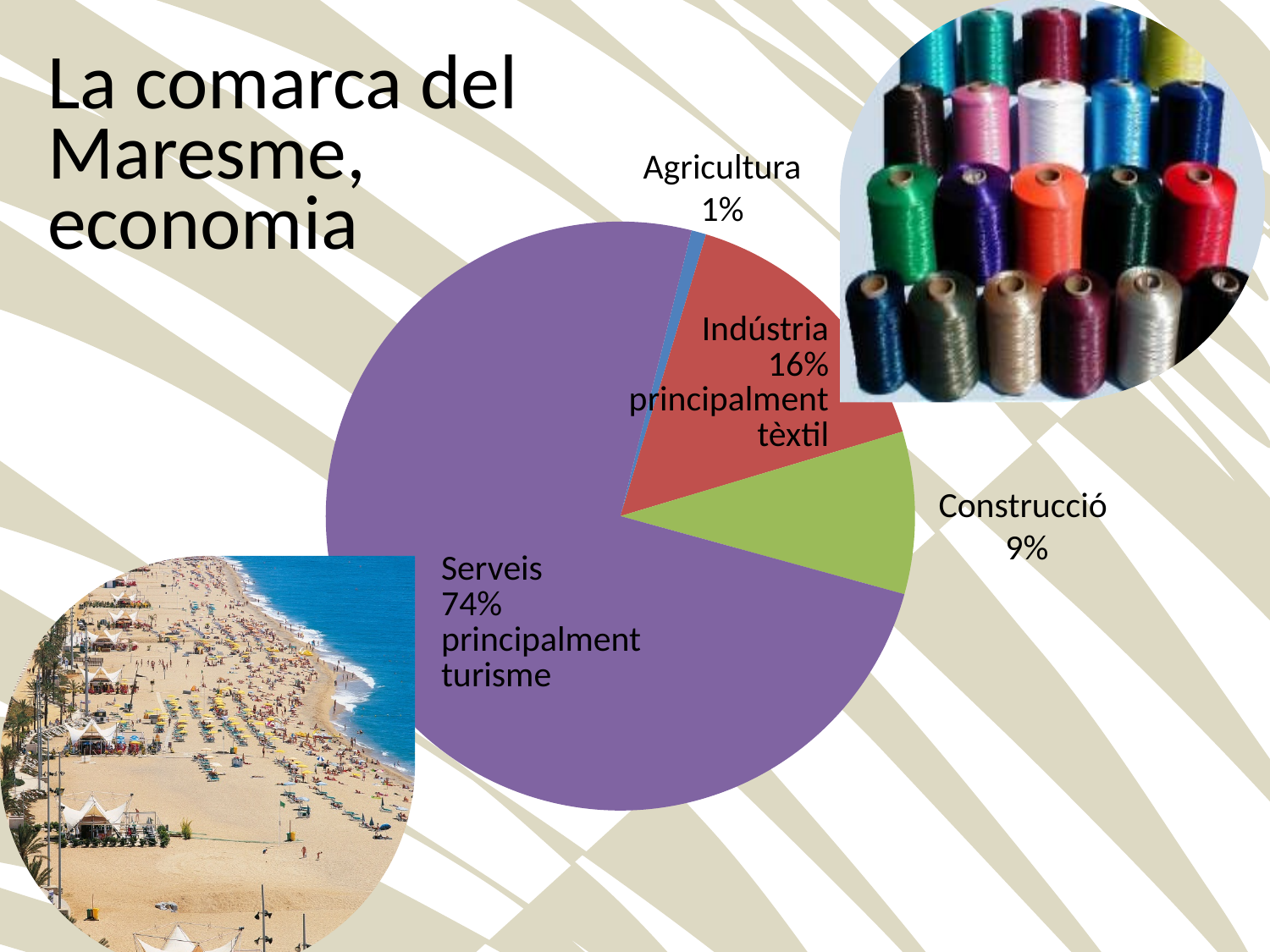
What kind of chart is shown on the slide? pie chart Which sector has the largest slice of the pie? Serveis What share of the pie does Agricultura represent? 1% What share of the pie does Construcció represent? 9% What is the difference in percentage points between Serveis and Indústria? 58 How many slices does the pie chart have? 4 Which is larger, the Construcció slice or the Indústria slice? Indústria What colour is the Serveis slice? purple What is the difference in percentage points between Indústria and Construcció? 7 What share of the pie does Serveis represent? 74% Which sector has the smallest slice of the pie? Agricultura